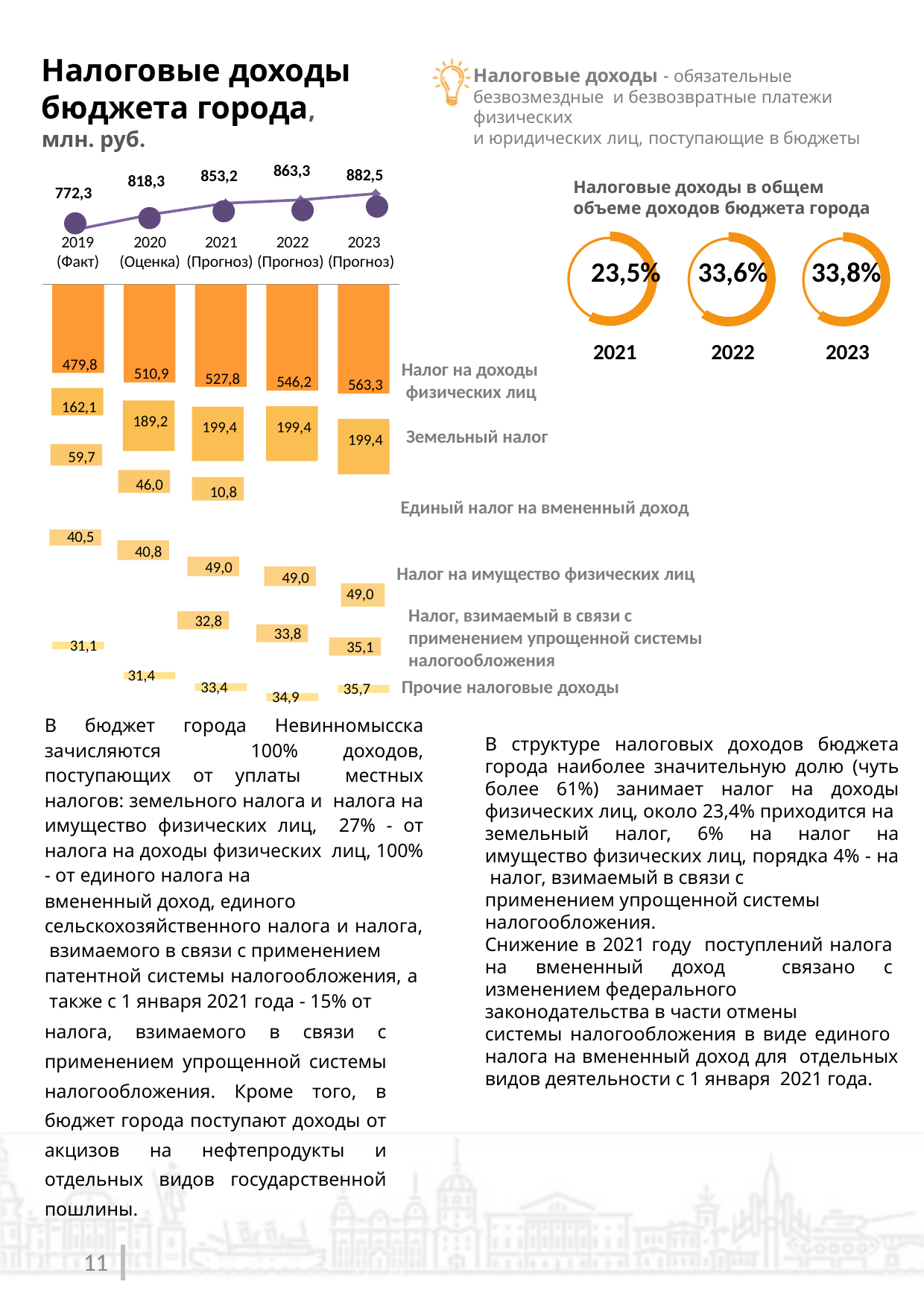
On the bar chart of tax types, what is the value of 'Единый налог на вмененный доход' for 2021? 10,8 On the line chart 'Налоговые доходы бюджета города', what is the value for 2019 (Факт)? 772,3 On the bar chart of tax types, which is larger in 2019: 'Земельный налог' or 'Единый налог на вмененный доход'? Земельный налог On the bar chart of tax types, what is the value of 'Налог на доходы физических лиц' for 2021? 527,8 On the donut charts 'Налоговые доходы в общем объеме доходов бюджета города', what is the share for 2022? 33,6% On the bar chart of tax types, which year has the highest value for 'Налог на доходы физических лиц'? 2023 On the line chart 'Налоговые доходы бюджета города', what is the value for 2023 (Прогноз)? 882,5 On the bar chart of tax types, what is the value of 'Земельный налог' for 2020? 189,2 On the line chart 'Налоговые доходы бюджета города', how many years are plotted? 5 On the line chart 'Налоговые доходы бюджета города', what is the difference between the 2023 and 2019 values? 110,2 On the line chart 'Налоговые доходы бюджета города', do the values rise or fall from 2019 to 2023? rise On the bar chart of tax types, what is the value of 'Налог на имущество физических лиц' for 2023? 49,0